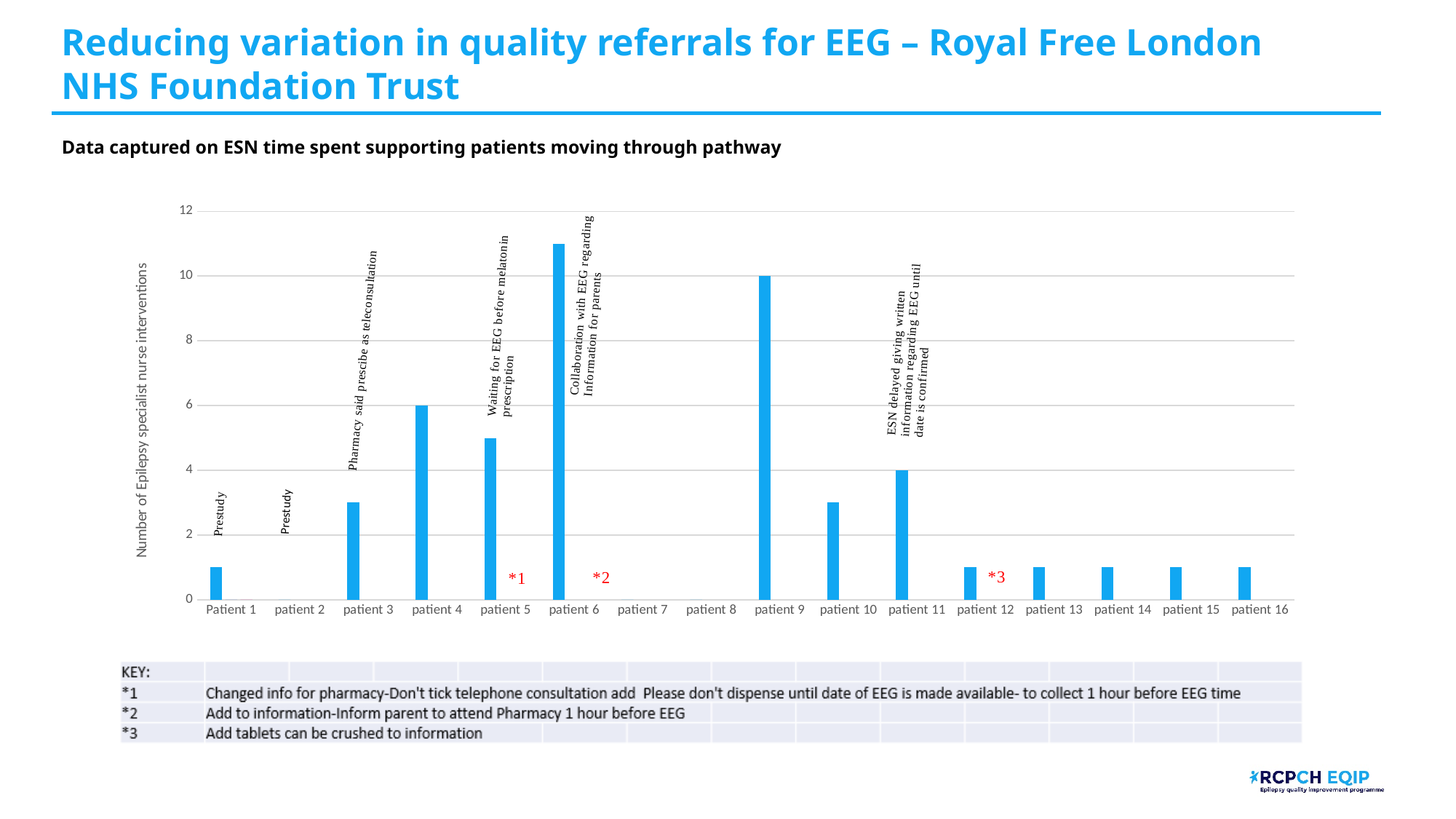
How many patients are shown on the x axis of the chart? 16 What is the label on the y axis of the chart? Number of Epilepsy specialist nurse interventions Is the value for patient 6 greater or less than 10? greater Which has more Epilepsy specialist nurse interventions, patient 4 or patient 10? patient 4 What is the number of Epilepsy specialist nurse interventions for patient 11? 4 What is the number of Epilepsy specialist nurse interventions for patient 9? 10 Is the value for patient 12 greater or less than 2? less Is the value for patient 5 greater or less than 4? greater Which patient has the highest number of Epilepsy specialist nurse interventions? patient 6 What kind of chart is shown on the slide? bar chart Which has more Epilepsy specialist nurse interventions, patient 9 or patient 11? patient 9 What is the number of Epilepsy specialist nurse interventions for patient 4? 6